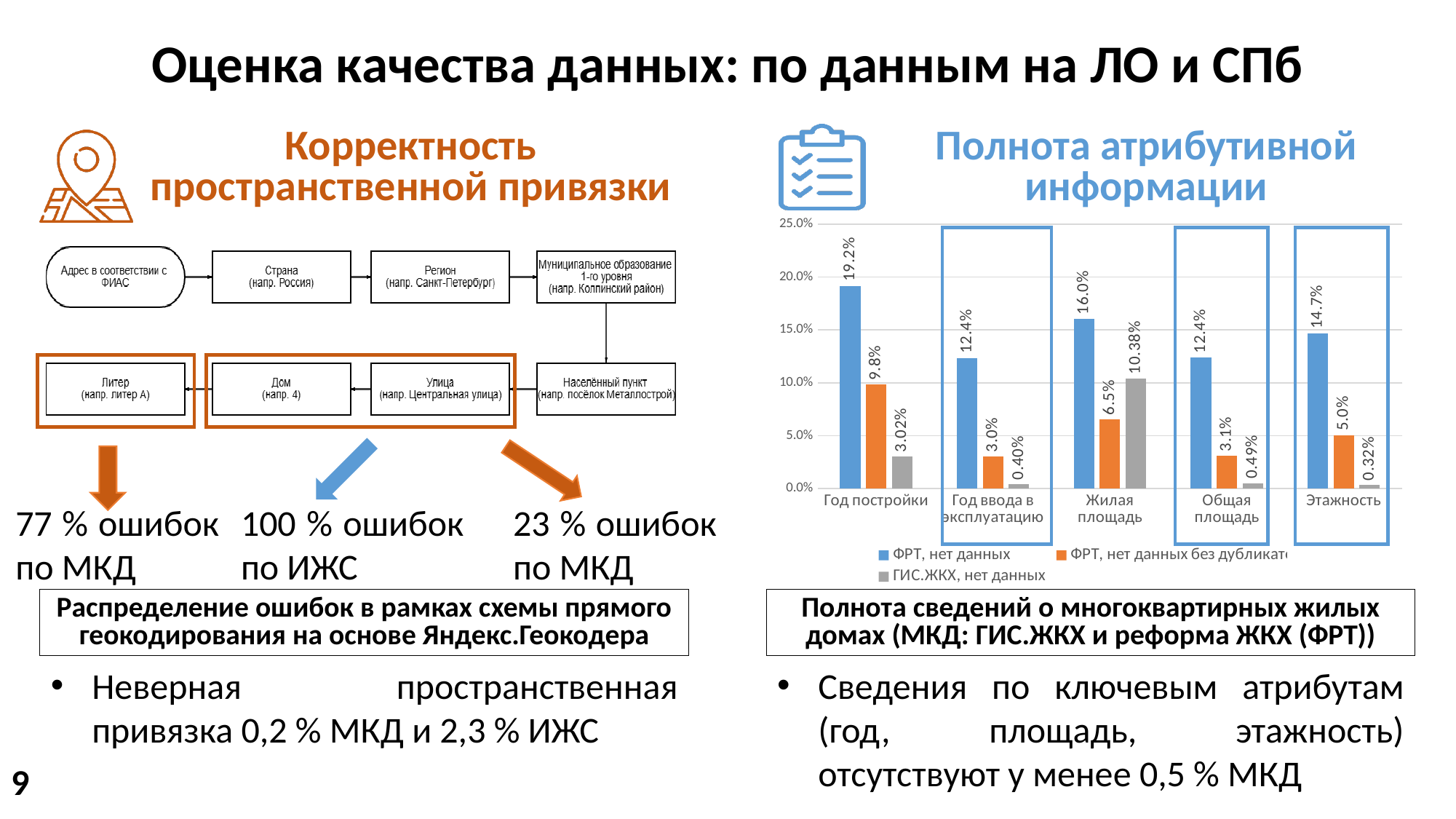
How many categories are shown on the x axis of the bar chart? 5 Is the "ФРТ, нет данных" value for "Год ввода в эксплуатацию" greater or less than 15.0%? less What is the value of the "ГИС.ЖКХ, нет данных" series for "Жилая площадь"? 10.38% What is the difference between the "ФРТ, нет данных" values for "Год постройки" and "Жилая площадь"? 3.2% For "Жилая площадь", which is larger: the orange series value or the "ГИС.ЖКХ, нет данных" value? ГИС.ЖКХ, нет данных What is the value of the "ФРТ, нет данных" series for "Год постройки"? 19.2% What is the value of the "ГИС.ЖКХ, нет данных" series for "Общая площадь"? 0.49% Which category has the lowest value in the "ГИС.ЖКХ, нет данных" series? Этажность Which category has the highest value in the "ФРТ, нет данных" series? Год постройки How many series does the legend of the bar chart list? 3 What kind of chart is shown under the heading "Полнота атрибутивной информации"? bar chart What is the value of the "ФРТ, нет данных" series for "Этажность"? 14.7%